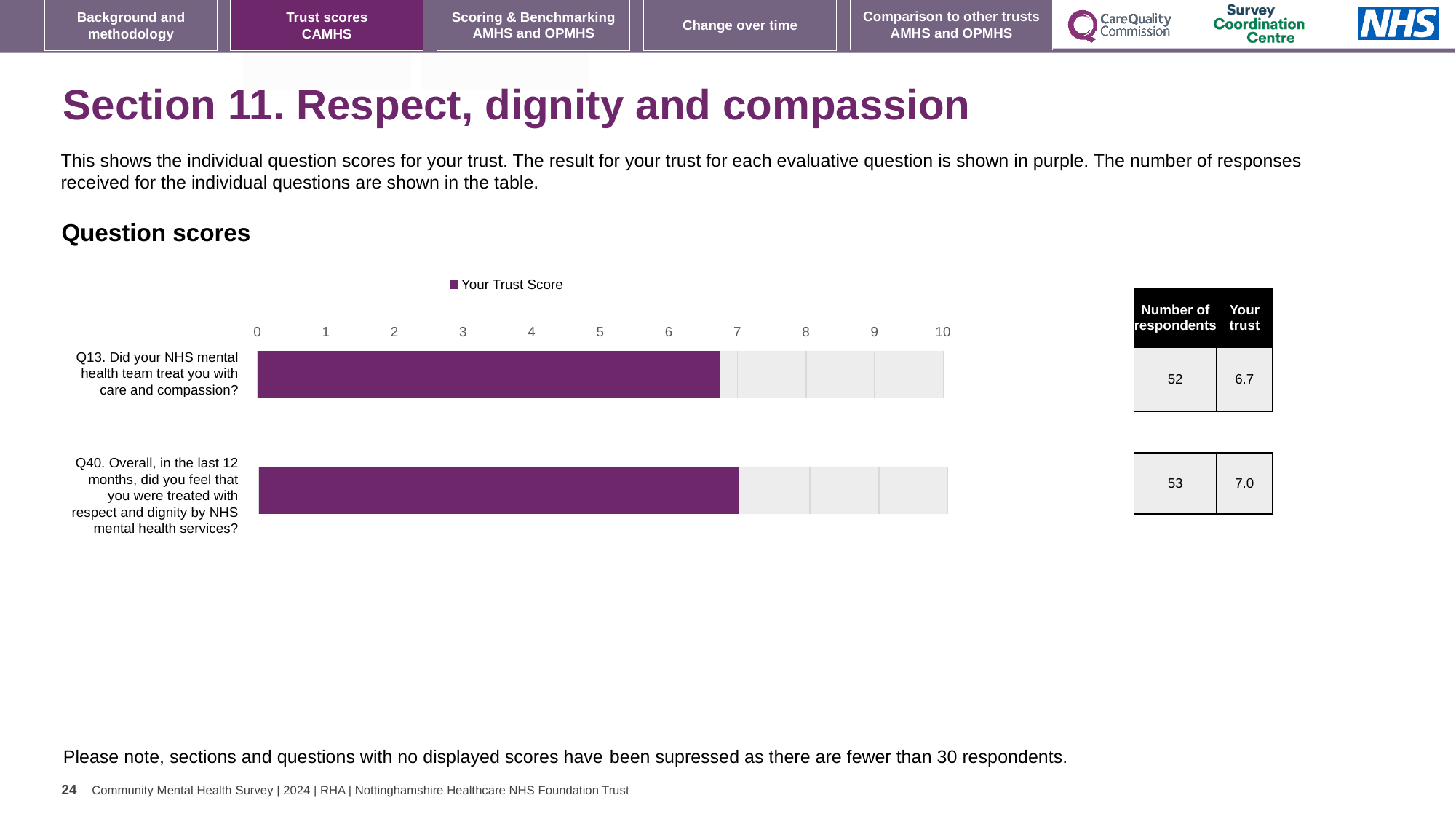
How many questions are plotted on the Question scores chart? 2 Is the Your Trust Score for Q13 greater or less than 7? less Which question has the lowest Your Trust Score on the chart? Q13 What type of chart is used to show the question scores? Bar chart Is the Your Trust Score for Q40 greater or less than 6? greater What is the difference between the Your Trust Score for Q40 and Q13? 0.3 Which question has the higher Your Trust Score, Q13 or Q40? Q40 What is the maximum value shown on the chart's axis? 10 What is the Your Trust Score for Q40 (Overall, in the last 12 months, did you feel that you were treated with respect and dignity by NHS mental health services?)? 7.0 What is the Your Trust Score for Q13 (Did your NHS mental health team treat you with care and compassion?)? 6.7 How many series does the chart legend list? 1 What is the name of the series shown in the chart legend? Your Trust Score